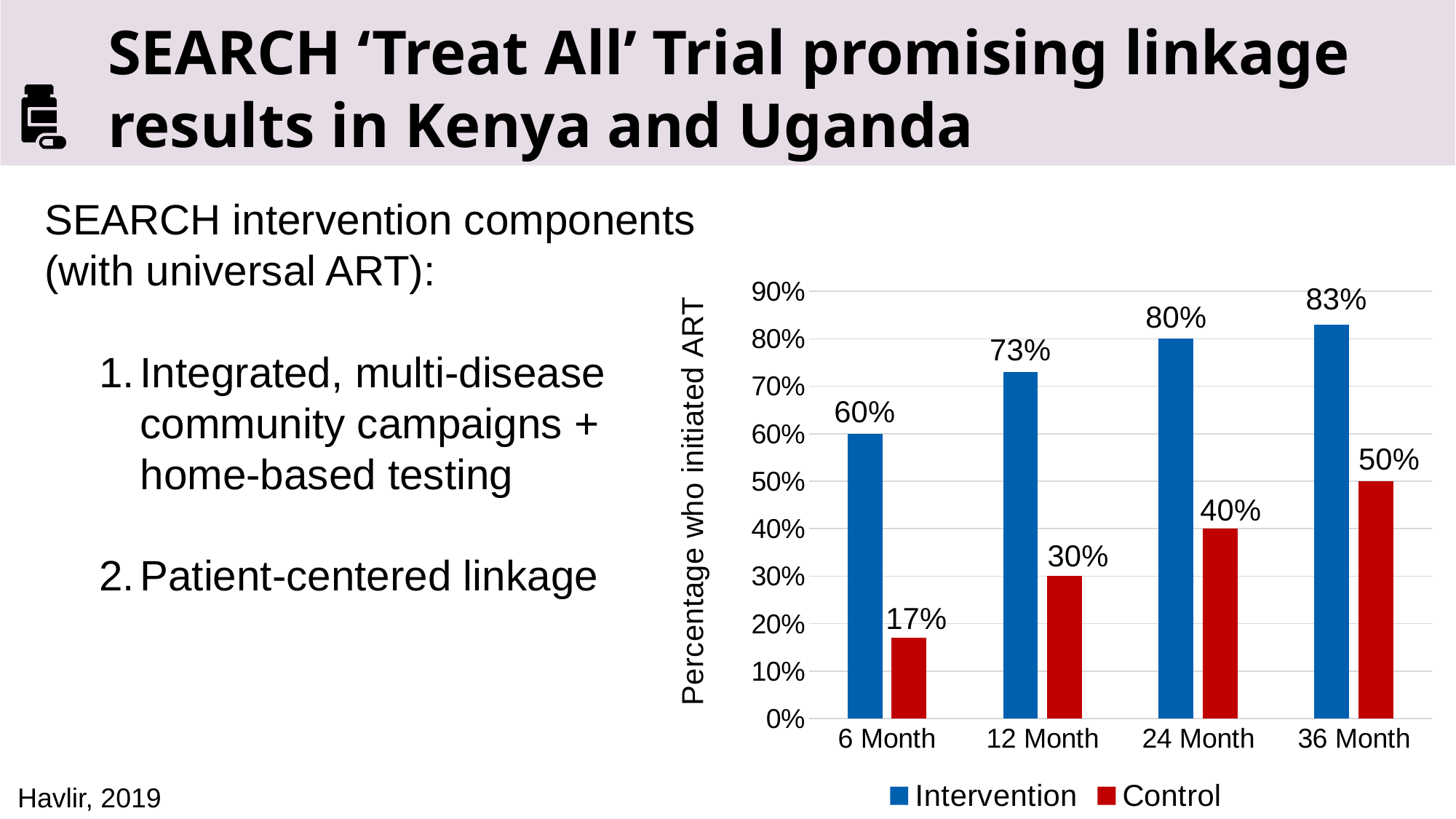
What is the Intervention value at 6 Month? 60% What kind of chart is shown on the slide? Bar chart How many series does the legend list? 2 What is the Control value at 36 Month? 50% Do the Control values rise or fall from 6 Month to 36 Month? Rise At which time point is the Control value lowest? 6 Month What is the difference between the Intervention and Control values at 12 Month? 43% Which is larger at 24 Month, the Intervention value or the Control value? Intervention What is the difference between the Intervention values at 36 Month and 6 Month? 23% At which time point is the Intervention value highest? 36 Month How many time points are shown on the x axis? 4 What is the Control value at 24 Month? 40%